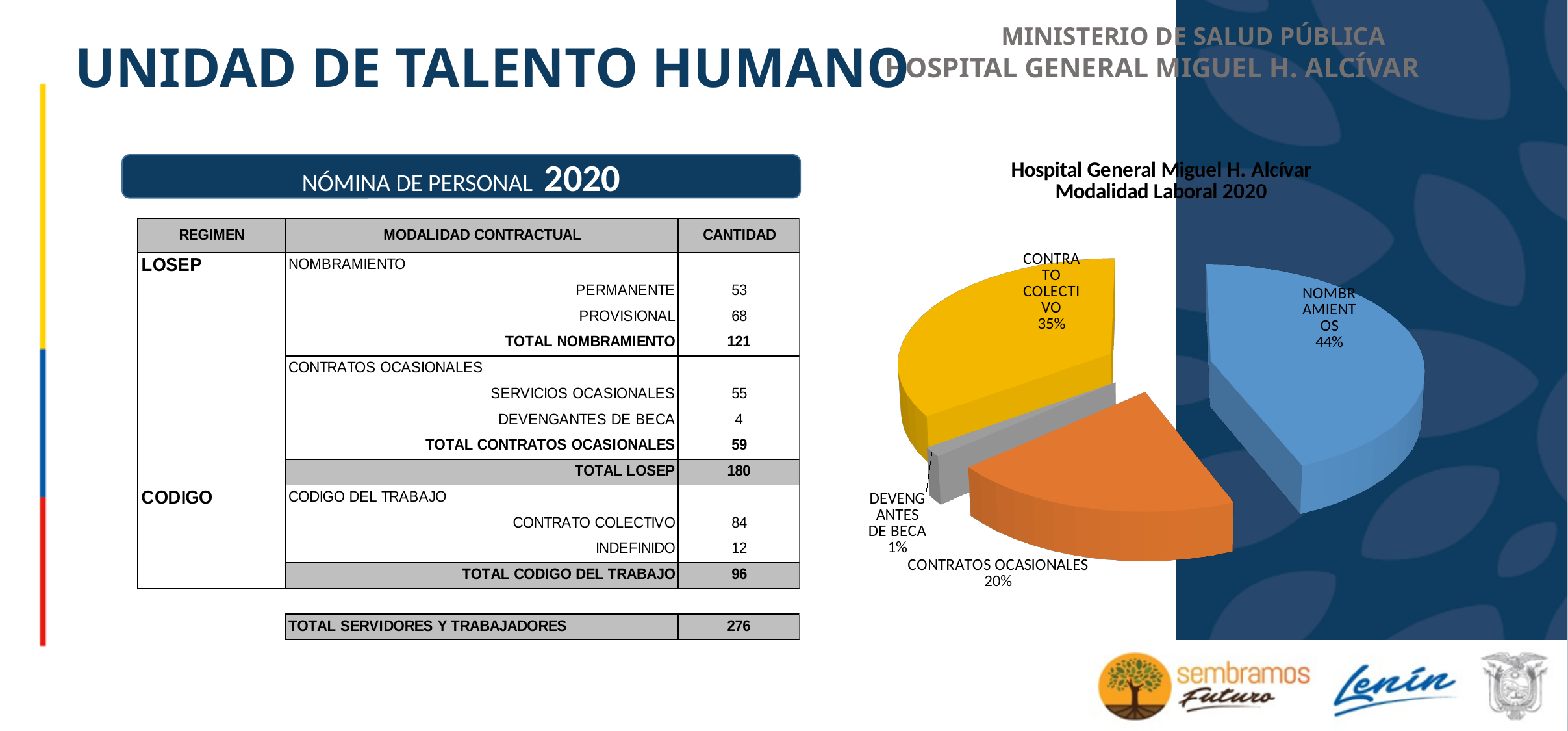
Which slice of the pie chart is the largest? NOMBRAMIENTOS In the pie chart, what is the difference in percentage points between NOMBRAMIENTOS and CONTRATO COLECTIVO? 9 percentage points What share of the pie chart does DEVENGANTES DE BECA represent? 1% What share of the pie chart does CONTRATO COLECTIVO represent? 35% How many slices does the pie chart have? 4 What type of chart is shown on the slide? Pie chart Which slice of the pie chart is the smallest? DEVENGANTES DE BECA What is the title of the pie chart? Hospital General Miguel H. Alcívar Modalidad Laboral 2020 What colour is the NOMBRAMIENTOS slice in the pie chart? Blue In the pie chart, which is larger: CONTRATOS OCASIONALES or CONTRATO COLECTIVO? CONTRATO COLECTIVO What share of the pie chart does NOMBRAMIENTOS represent? 44%